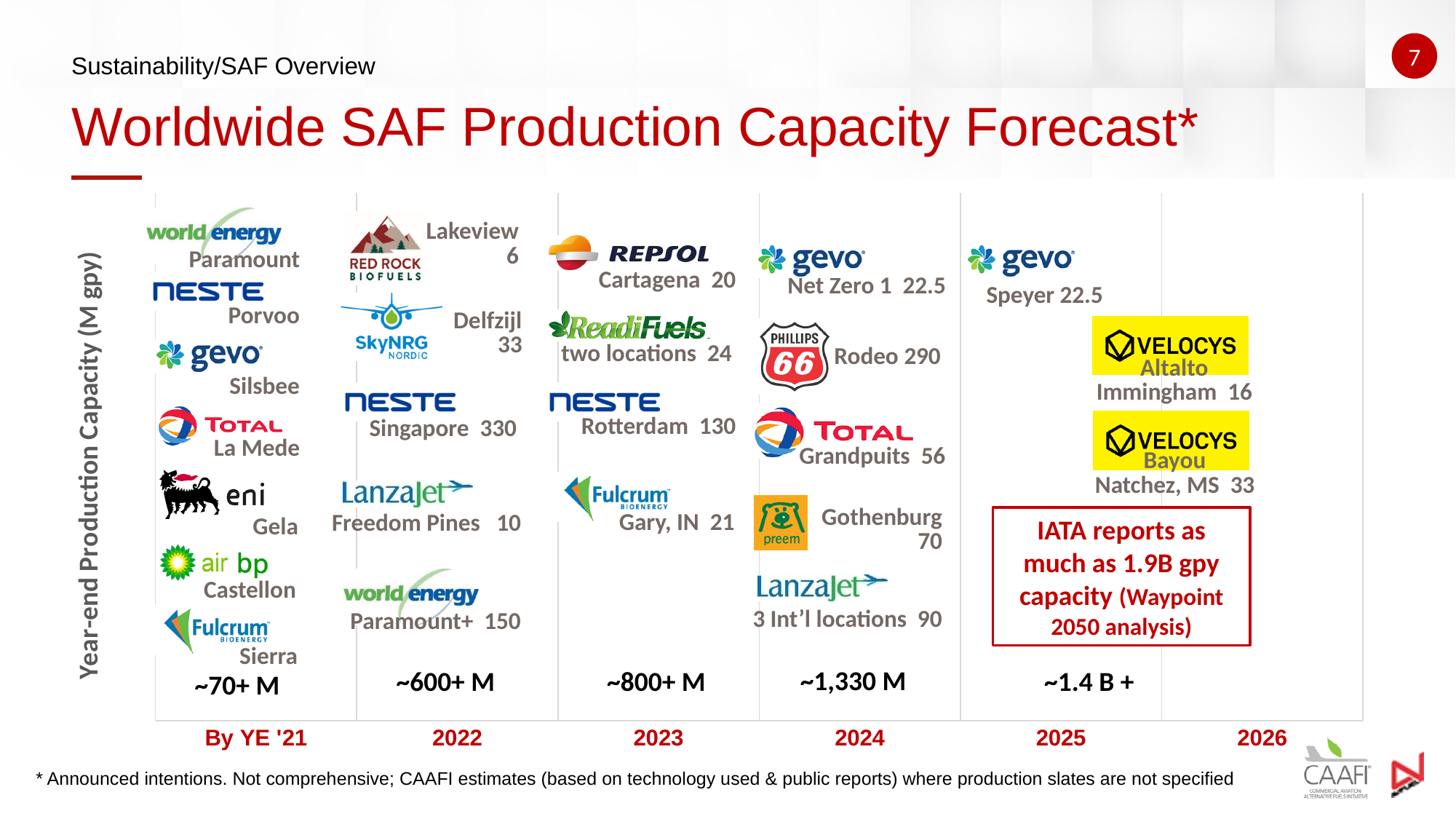
Which Velocys project has the larger listed capacity, Altalto Immingham or Bayou Natchez, MS? Bayou Natchez, MS What capacity is listed for the Phillips 66 Rodeo project in the 2024 column? 290 Which project in the 2024 column has the highest listed capacity? Phillips 66 Rodeo What capacity is shown for Neste Rotterdam in the 2023 column? 130 What is the capacity shown for the Neste Singapore project in the 2022 column? 330 What is the difference between the Neste Singapore capacity (2022) and the Neste Rotterdam capacity (2023)? 200 What cumulative capacity total is printed at the bottom of the 2023 column? ~800+ M Which project in the 2022 column has the lowest listed capacity? Red Rock Biofuels Lakeview What capacity is listed for the Gevo Speyer project in the 2025 column? 22.5 What is the label on the vertical axis of the chart? Year-end Production Capacity (M gpy) How many year labels are shown along the x axis? 6 What cumulative capacity total is printed at the bottom of the 2024 column? ~1,330 M